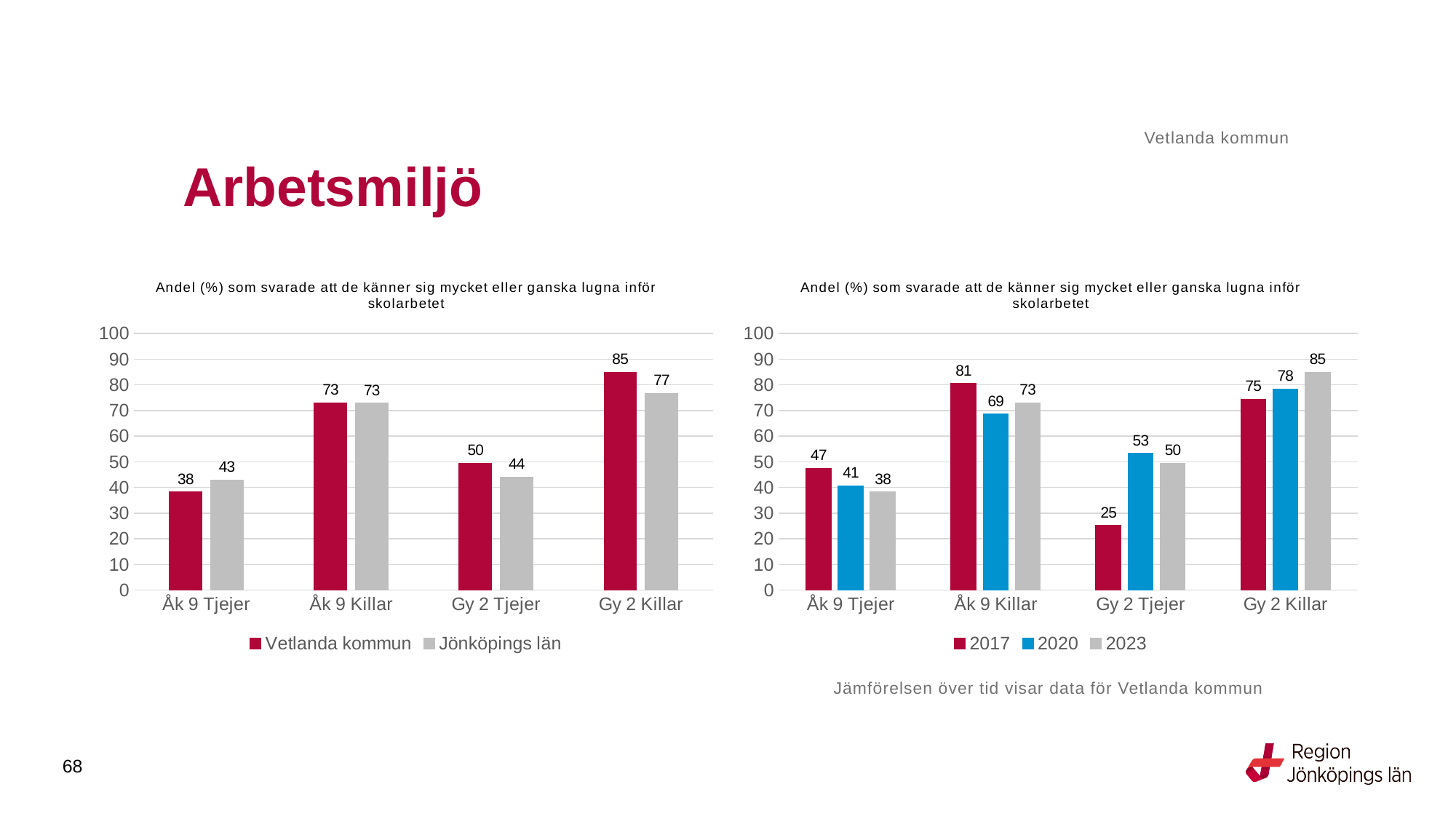
In the right chart, what is the value for 2017 for Åk 9 Killar? 81 In the left chart, what is the difference between Vetlanda kommun and Jönköpings län for Gy 2 Tjejer? 6 In the left chart, what is the value for Vetlanda kommun for Åk 9 Tjejer? 38 In the right chart, what is the value for 2020 for Gy 2 Tjejer? 53 In the right chart, what is the difference between the 2017 and 2023 values for Åk 9 Tjejer? 9 In the right chart, which category has the lowest value for 2017? Gy 2 Tjejer What kind of chart is the right chart? bar chart In the left chart, how many series does the legend list? 2 In the right chart, how many categories are shown on the x axis? 4 In the right chart, is the 2023 value for Gy 2 Killar larger or smaller than the 2020 value? larger In the left chart, which category has the highest value for Vetlanda kommun? Gy 2 Killar In the left chart, what is the value for Jönköpings län for Gy 2 Killar? 77